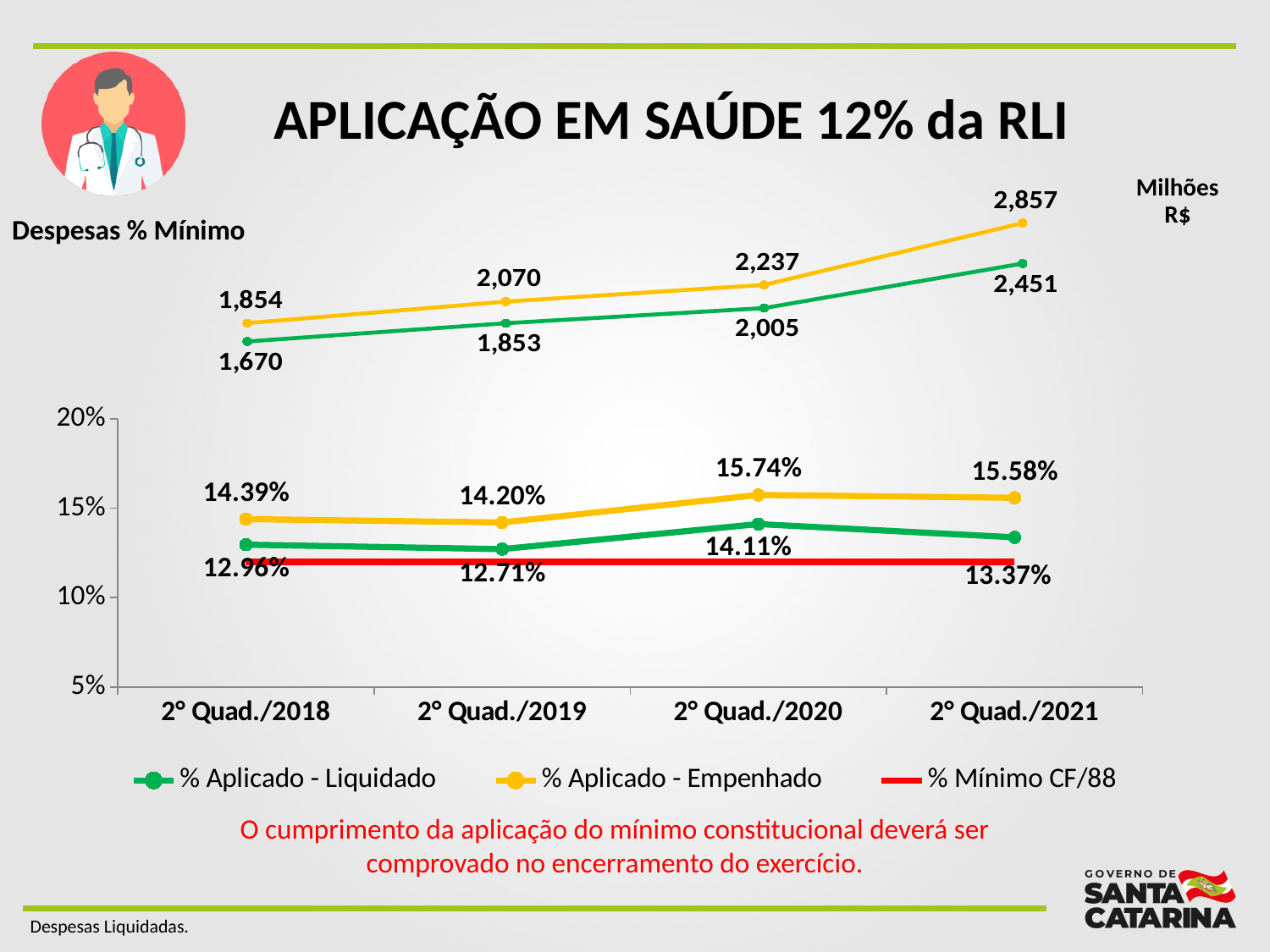
What kind of chart is the lower chart (Despesas % Mínimo)? Line chart In the lower chart (Despesas % Mínimo), which quadrimester has the highest value for % Aplicado - Liquidado? 2° Quad./2020 In the upper chart (Milhões R$), what is the value of the first point on the green line? 1,670 In the lower chart (Despesas % Mínimo), what is the value of % Aplicado - Empenhado for 2° Quad./2020? 15.74% In the lower chart (Despesas % Mínimo), what colour is the % Mínimo CF/88 line? Red In the lower chart (Despesas % Mínimo), what is the value of % Aplicado - Liquidado for 2° Quad./2019? 12.71% In the lower chart (Despesas % Mínimo), what is the difference between % Aplicado - Empenhado and % Aplicado - Liquidado for 2° Quad./2021? 2.21% In the lower chart (Despesas % Mínimo), how many quadrimesters are shown on the x axis? 4 In the upper chart (Milhões R$), what is the value of the last point on the yellow line? 2,857 In the lower chart (Despesas % Mínimo), how many series does the legend list? 3 In the upper chart (Milhões R$), what is the difference between the last and first points on the green line? 781 In the lower chart (Despesas % Mínimo), which quadrimester has the lowest value for % Aplicado - Empenhado? 2° Quad./2019